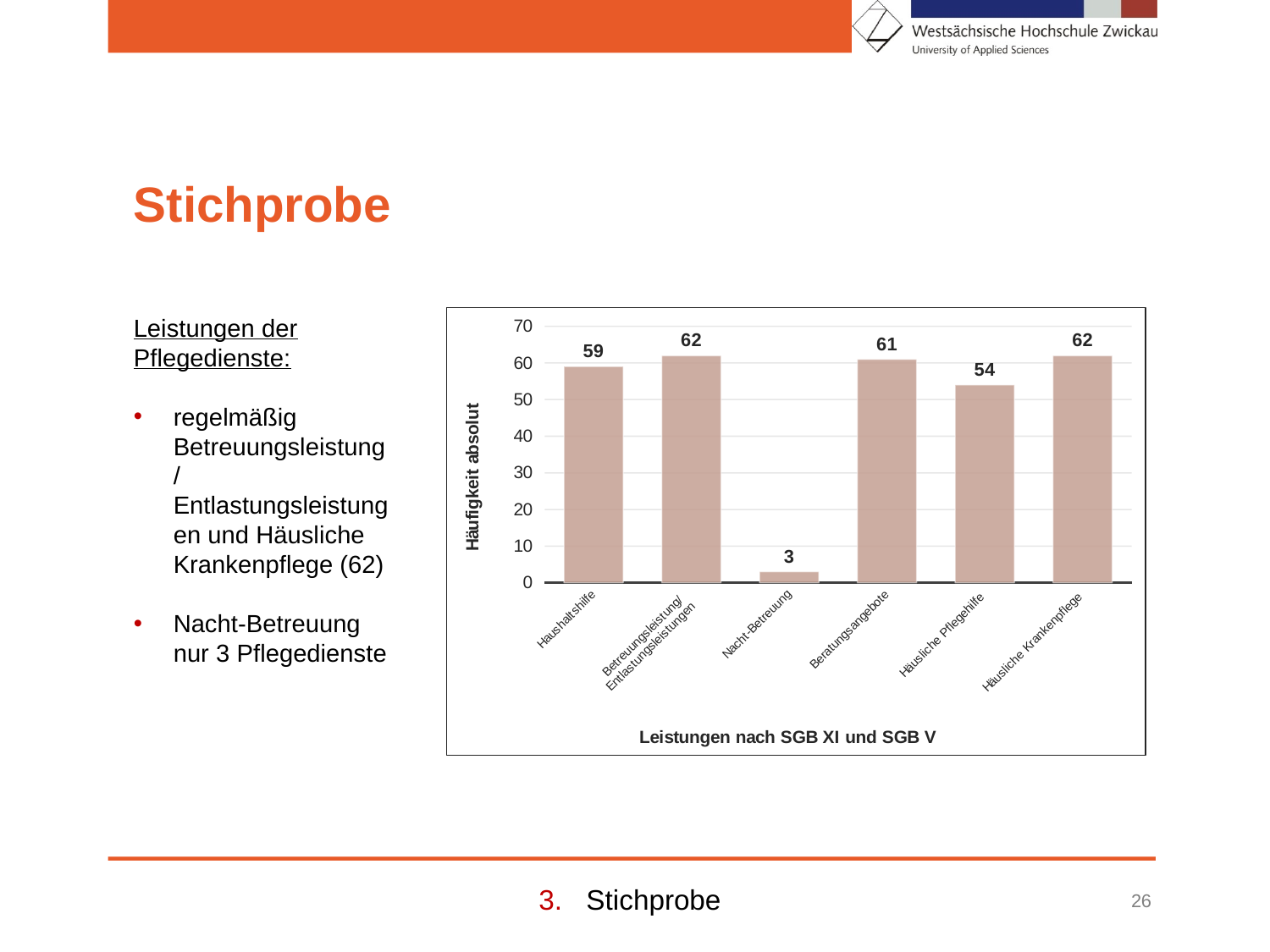
Is the value for Häusliche Pflegehilfe greater or less than 50? greater What is the value for Beratungsangebote? 61 Which is larger, the value for Beratungsangebote or the value for Häusliche Pflegehilfe? Beratungsangebote Which category has the lowest value? Nacht-Betreuung What is the difference between the values for Haushaltshilfe and Nacht-Betreuung? 56 What is the value for Nacht-Betreuung? 3 What is the label of the y axis? Häufigkeit absolut What kind of chart is shown? bar chart What is the value for Häusliche Pflegehilfe? 54 How many categories are shown on the x axis? 6 What is the value for Haushaltshilfe? 59 What is the difference between the values for Häusliche Krankenpflege and Häusliche Pflegehilfe? 8